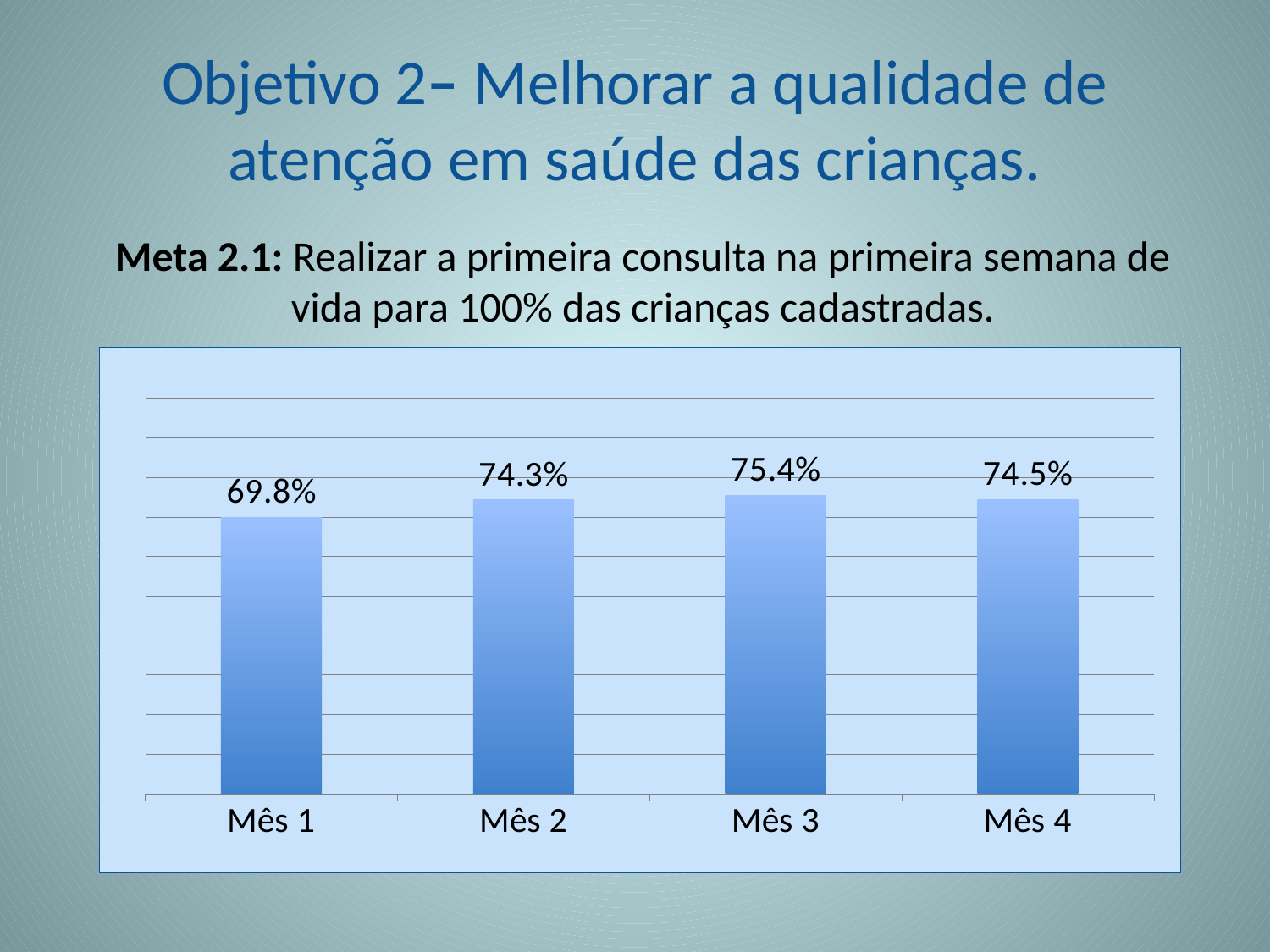
What is the value for Mês 3? 75.4% What is the value for Mês 4? 74.5% What is the value for Mês 2? 74.3% What is the value for Mês 1? 69.8% Which month has the lowest value? Mês 1 Does the value rise or fall from Mês 1 to Mês 2? Rise Does the value rise or fall from Mês 3 to Mês 4? Fall How many months are shown on the x axis? 4 Which is larger, the value for Mês 2 or the value for Mês 4? Mês 4 What kind of chart is shown on the slide? Bar chart What is the difference between the values for Mês 3 and Mês 1? 5.6 percentage points Which month has the highest value? Mês 3